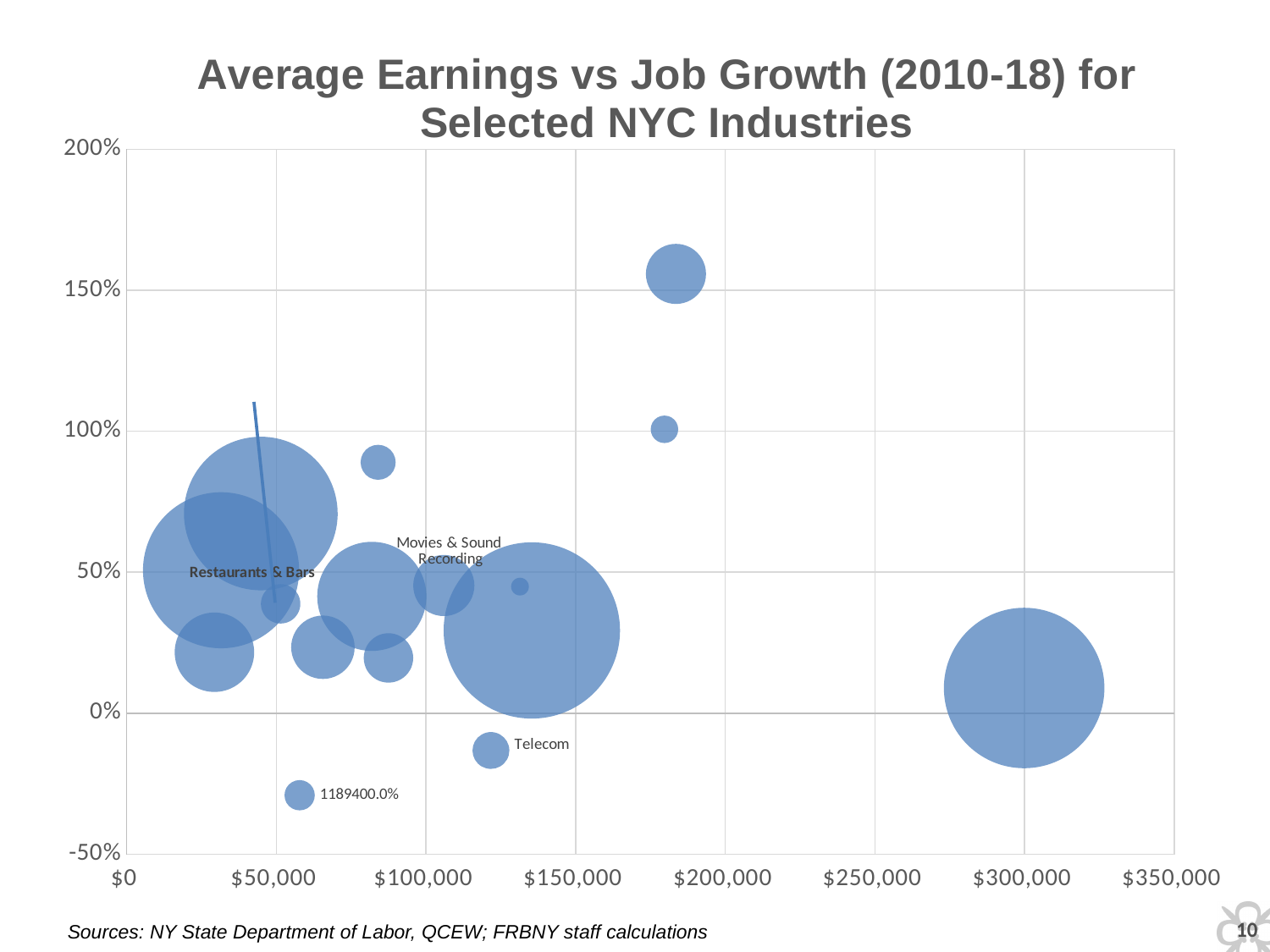
Is the job growth for Movies & Sound Recording greater or less than 100%? less Which has higher average earnings, Telecom or Restaurants & Bars? Telecom What is the title of the chart? Average Earnings vs Job Growth (2010-18) for Selected NYC Industries Is the job growth for Movies & Sound Recording greater or less than 0%? greater Is the highest job growth shown by any bubble greater or less than 150%? greater Among the labeled industries (Restaurants & Bars, Movies & Sound Recording, Telecom), which has the lowest job growth? Telecom What kind of chart is shown on the slide? Bubble chart Which has higher job growth, Telecom or Movies & Sound Recording? Movies & Sound Recording What is the maximum value shown on the horizontal (earnings) axis? $350,000